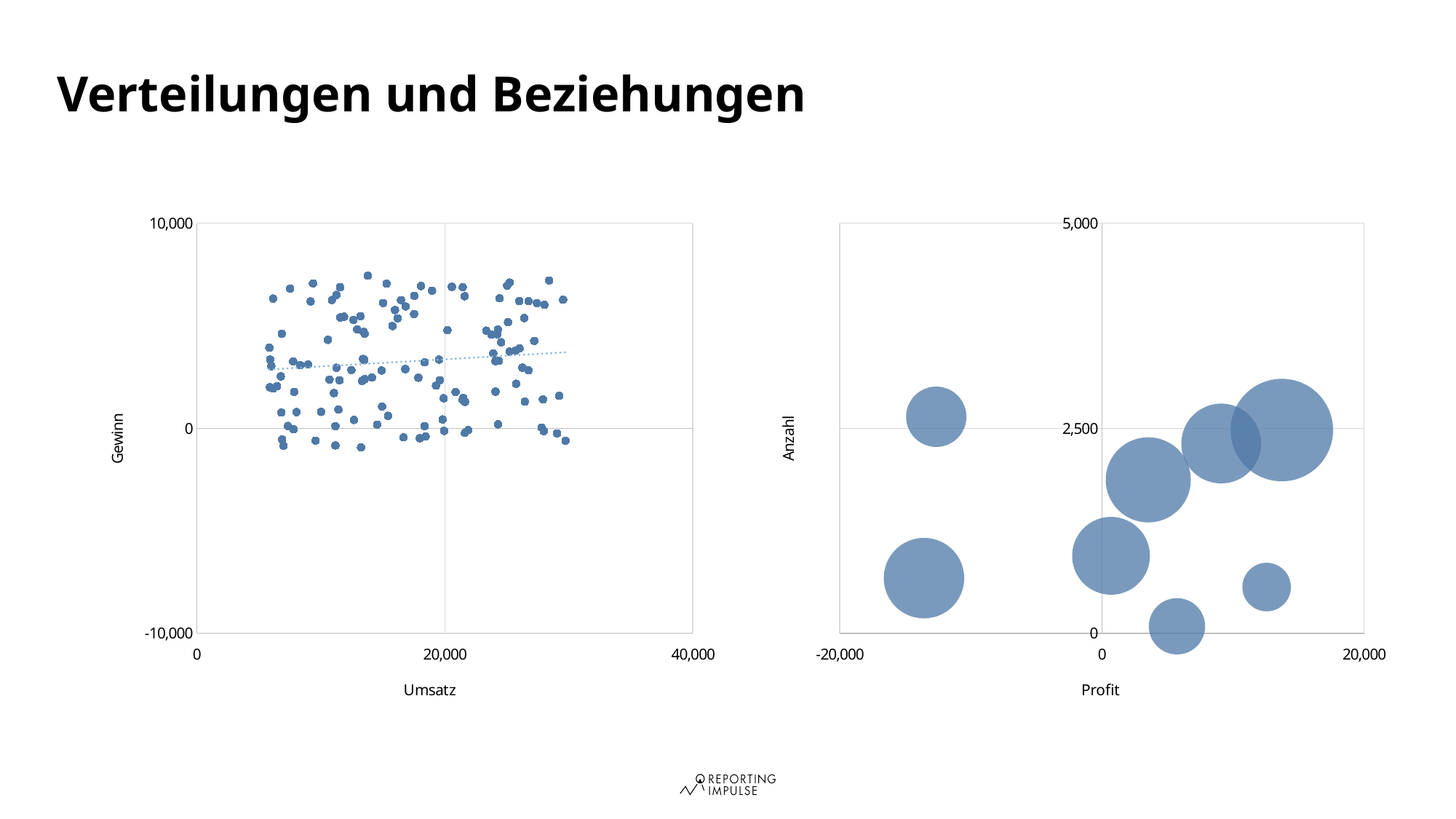
In the right chart, how many bubbles are plotted? 8 In the left chart, is the Umsatz of the rightmost point greater or less than 20,000? greater What kind of chart is the right chart (Profit vs. Anzahl)? bubble chart In the left chart, is the Gewinn of the highest point greater or less than 10,000? less In the left chart, does the dotted trend line rise or fall as Umsatz increases? rise In the right chart, is the Profit of the largest bubble greater or less than 0? greater In the right chart, what variable is plotted on the y axis? Anzahl What kind of chart is the left chart (Umsatz vs. Gewinn)? scatter chart In the left chart, what variable is plotted on the x axis? Umsatz In the right chart, how many bubbles have a negative Profit value? 2